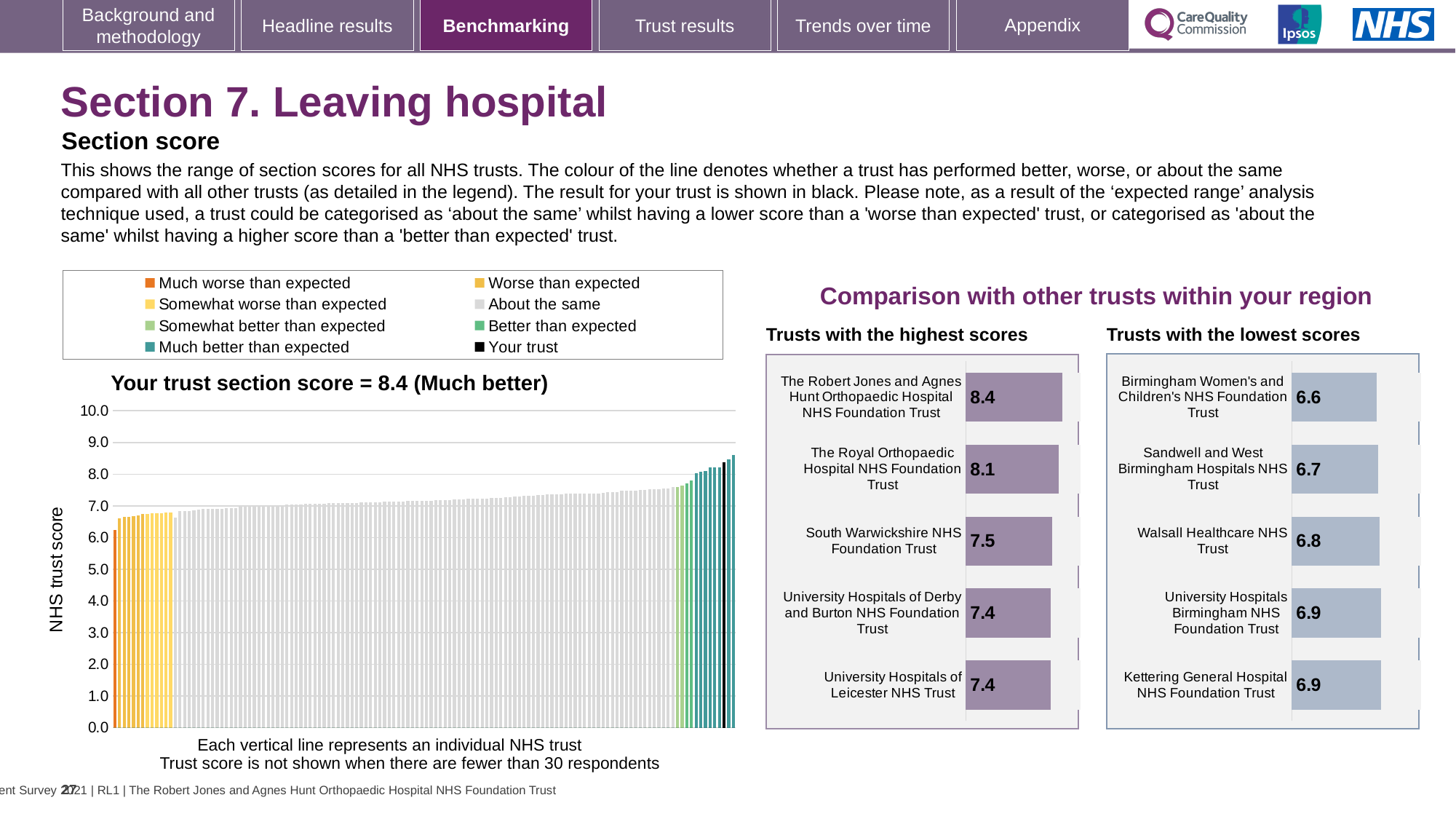
What kind of chart is the 'Your trust section score' chart? bar chart In the 'Trusts with the lowest scores' chart, which trust has the lowest score? Birmingham Women's and Children's NHS Foundation Trust How many entries does the legend above the 'Your trust section score' chart list? 8 In the 'Trusts with the highest scores' chart, what is the score for The Royal Orthopaedic Hospital NHS Foundation Trust? 8.1 In the 'Trusts with the highest scores' chart, what is the difference between the scores of The Robert Jones and Agnes Hunt Orthopaedic Hospital NHS Foundation Trust and South Warwickshire NHS Foundation Trust? 0.9 In the 'Trusts with the highest scores' chart, which trust has the highest score? The Robert Jones and Agnes Hunt Orthopaedic Hospital NHS Foundation Trust In the 'Trusts with the lowest scores' chart, what is the score for Walsall Healthcare NHS Trust? 6.8 How many trusts are listed in the 'Trusts with the highest scores' chart? 5 In the 'Your trust section score' chart, is the value of the black bar (your trust) greater or less than 8.0? greater In the 'Your trust section score' chart, what is the section score for your trust? 8.4 In the 'Trusts with the lowest scores' chart, which has the larger score: Sandwell and West Birmingham Hospitals NHS Trust or Walsall Healthcare NHS Trust? Walsall Healthcare NHS Trust In the 'Trusts with the lowest scores' chart, what is the difference between the scores of Kettering General Hospital NHS Foundation Trust and Birmingham Women's and Children's NHS Foundation Trust? 0.3